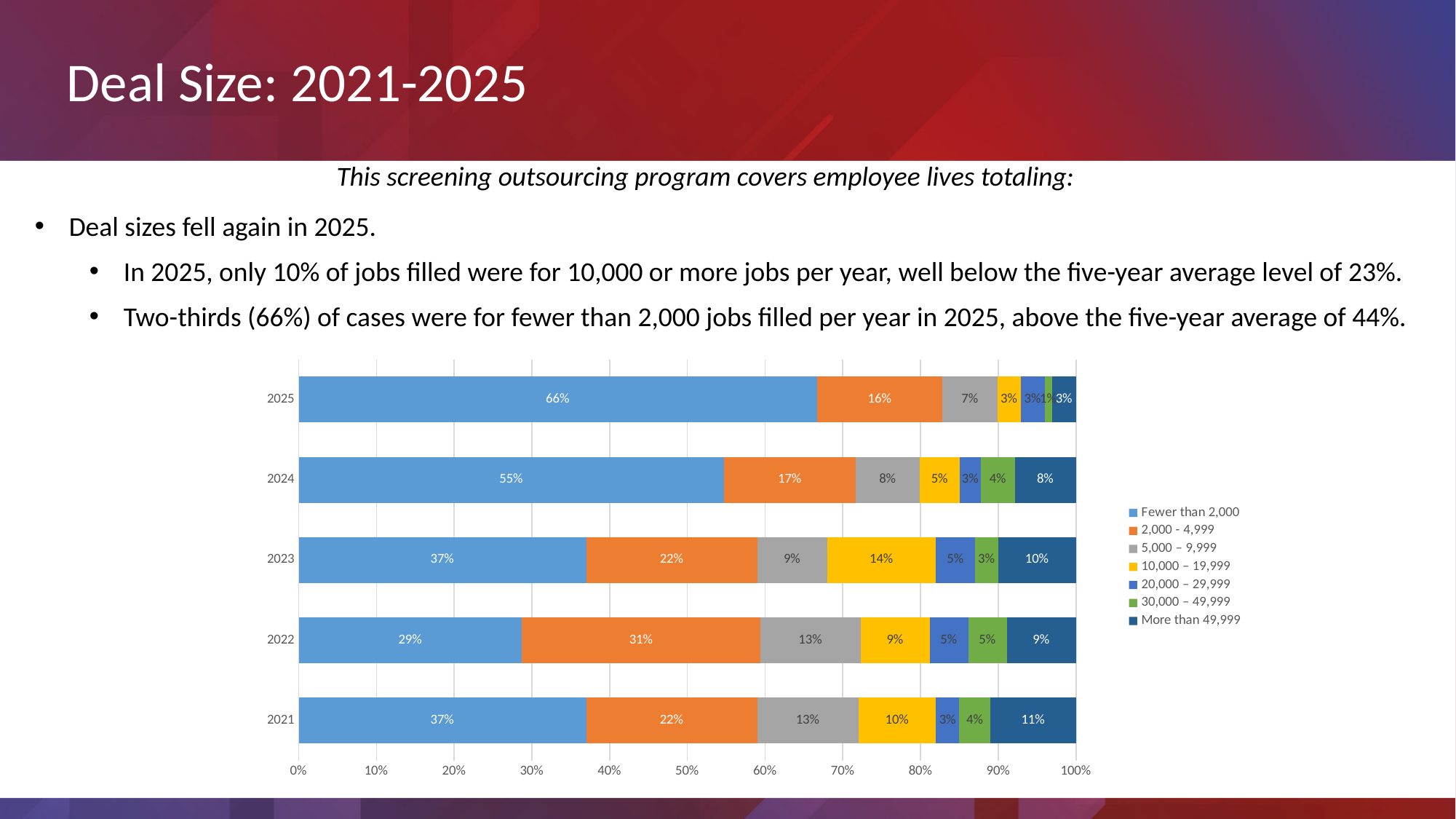
What kind of chart is shown on the slide? Stacked bar chart What is the value for '10,000 – 19,999' in 2023? 14% Which year has the highest value for 'Fewer than 2,000'? 2025 What is the value for '2,000 - 4,999' in 2022? 31% What is the value for 'More than 49,999' in 2021? 11% Which series is shown in orange in the legend? 2,000 - 4,999 What is the difference between the 'Fewer than 2,000' values for 2025 and 2024? 11% Which is larger: the '5,000 – 9,999' value in 2022 or in 2024? 2022 How many years are shown on the chart? 5 What is the value for 'Fewer than 2,000' in 2025? 66% Which year has the lowest value for 'Fewer than 2,000'? 2022 How many series does the legend list? 7